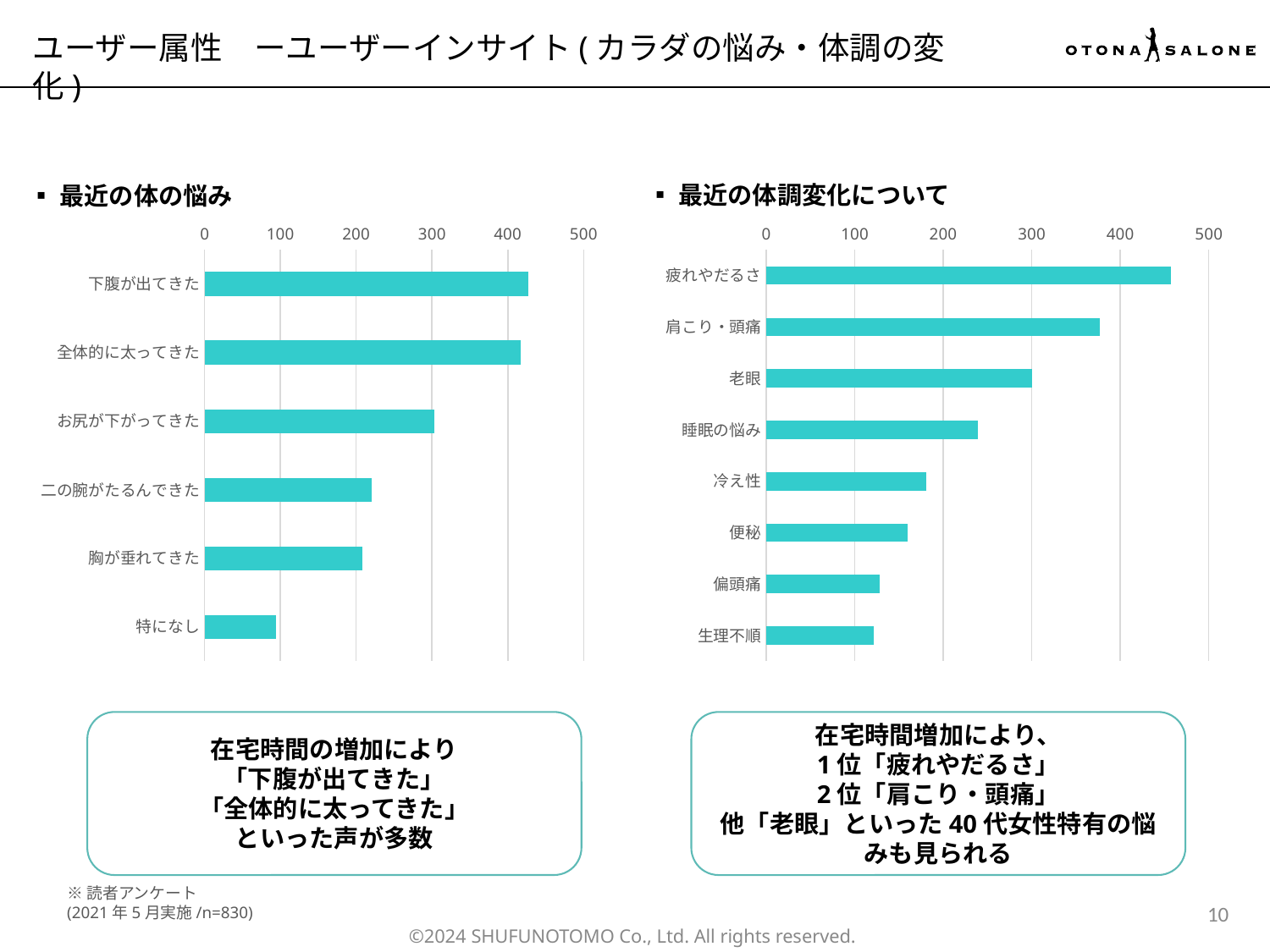
What kind of chart is the 最近の体の悩み chart on the left? bar chart How many categories does the 最近の体の悩み chart on the left show? 6 In the 最近の体調変化について chart, is the value for 疲れやだるさ greater or less than 400? greater In the 最近の体調変化について chart, which category has the highest value? 疲れやだるさ How many categories does the 最近の体調変化について chart on the right show? 8 What is the title of the chart on the right side of the slide? 最近の体調変化について In the 最近の体調変化について chart, is the value for 睡眠の悩み greater or less than 200? greater In the 最近の体の悩み chart, which category has the lowest value? 特になし In the 最近の体の悩み chart, is the value for 下腹が出てきた greater or less than 400? greater In the 最近の体の悩み chart, which is larger, お尻が下がってきた or 二の腕がたるんできた? お尻が下がってきた In the 最近の体調変化について chart, which is larger, 老眼 or 睡眠の悩み? 老眼